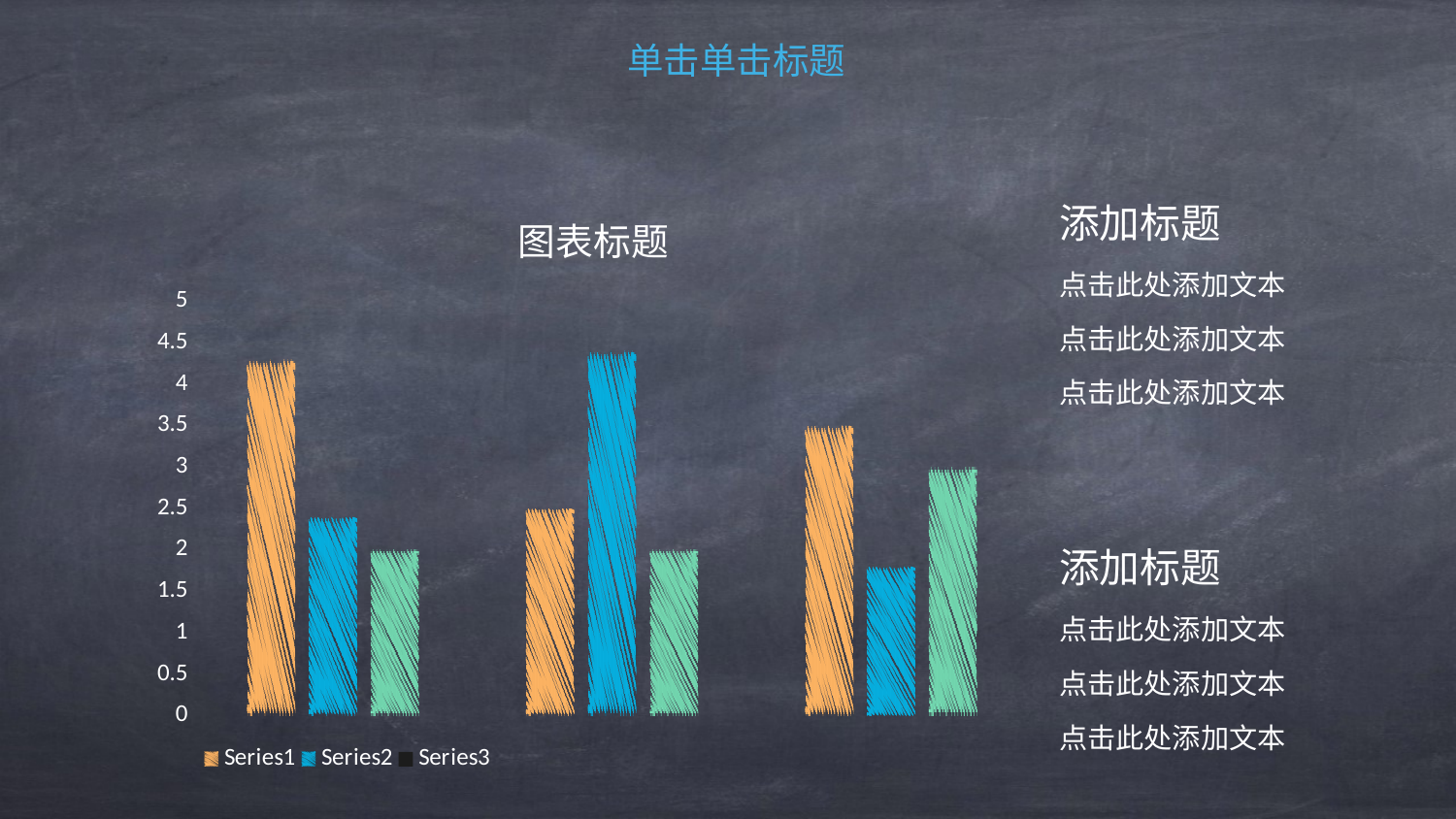
In which group of bars (first, second or third) is Series2 highest? second What is the title of the chart? 图表标题 In which group of bars (first, second or third) is Series1 highest? first In which group of bars (first, second or third) is Series3 highest? third In which group of bars (first, second or third) is Series1 lowest? second What are the names of the series listed in the legend? Series1, Series2, Series3 In the first group of bars, which is larger, Series1 or Series2? Series1 Is the value for Series1 in the first group greater or less than 4? greater What kind of chart is shown on the slide? bar chart Is the value for Series2 in the third group greater or less than 2? less How many series does the chart legend list? 3 How many groups of bars are plotted along the x axis? 3